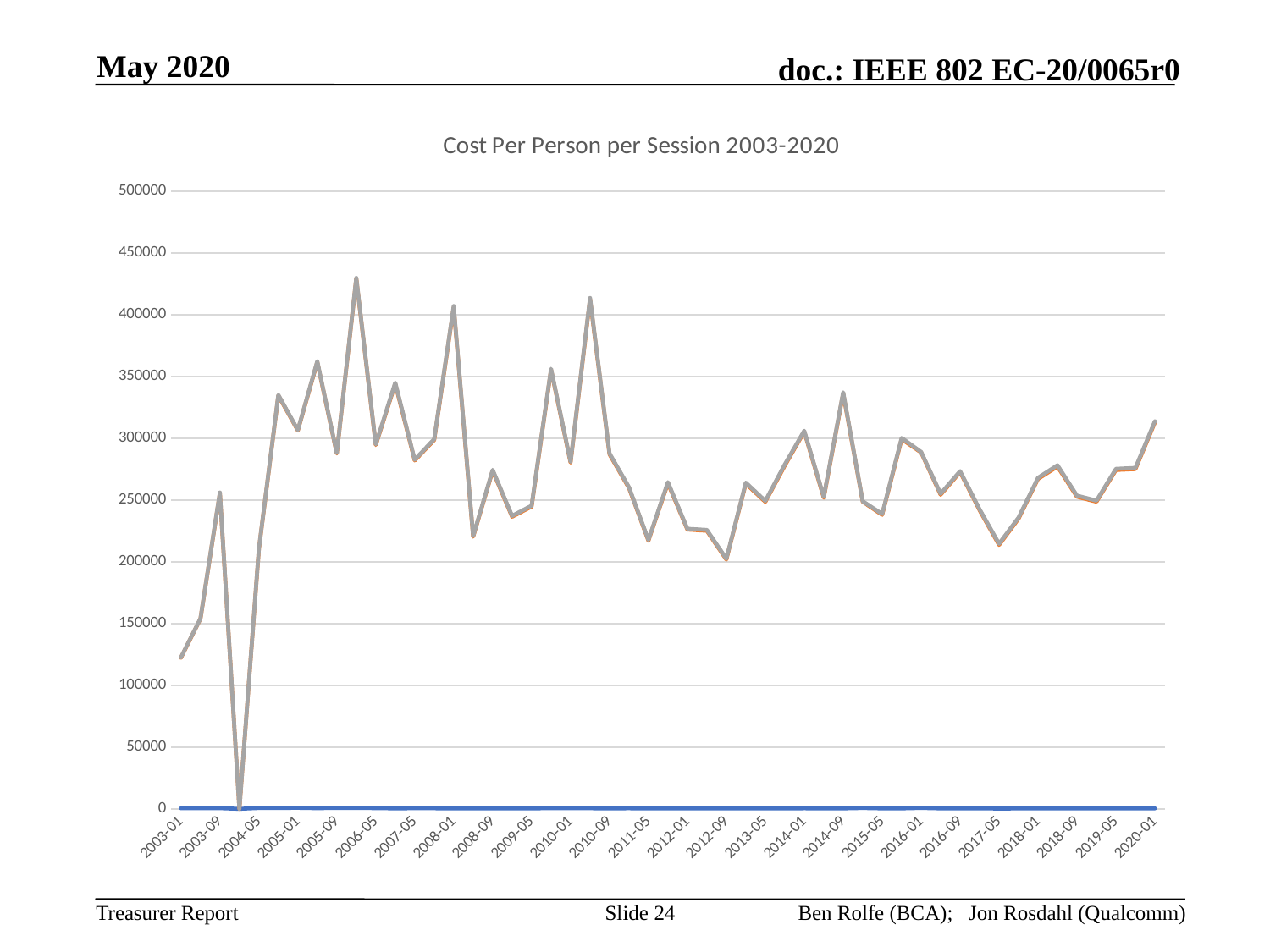
Is the value for 2014-09 greater or less than 300000? greater What kind of chart is shown on the slide? line chart What is the highest value shown on the vertical axis? 500000 Which is larger, the value for 2003-01 or the value for 2003-09? 2003-09 Is the value for 2020-01 greater or less than 250000? greater Is the value for 2012-09 greater or less than 250000? less Which is larger, the value for 2008-01 or the value for 2012-09? 2008-01 What is the title of the chart? Cost Per Person per Session 2003-2020